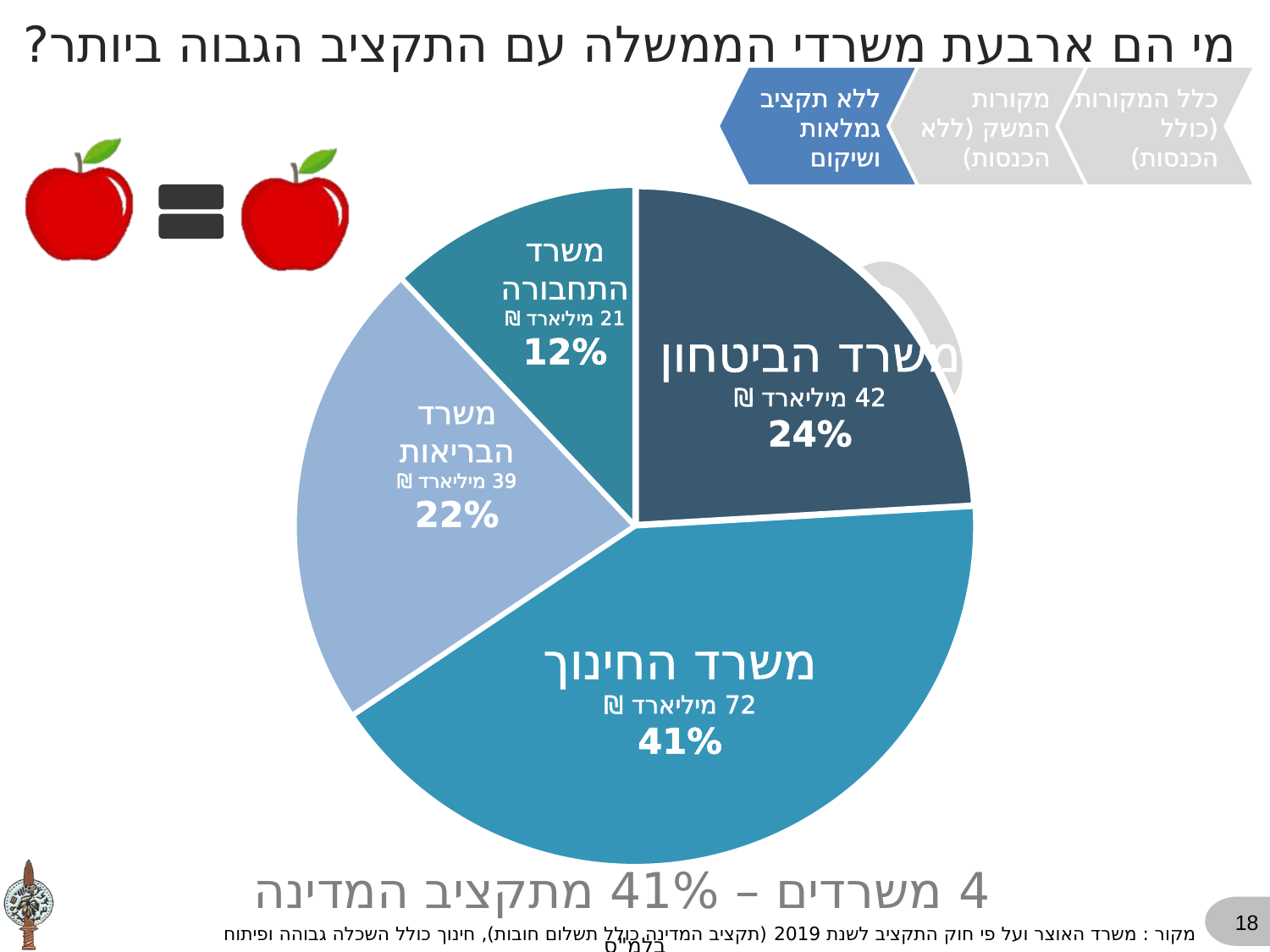
What percentage of the pie is the slice for משרד החינוך (Ministry of Education)? 41% What percentage of the pie is the slice for משרד התחבורה (Ministry of Transportation)? 12% Which ministry has the smallest slice of the pie? משרד התחבורה What budget value is printed for משרד החינוך (Ministry of Education)? 72 מיליארד ₪ What is the difference in billions of ₪ between the budgets of משרד הביטחון (42) and משרד הבריאות (39)? 3 What percentage of the pie is the slice for משרד הבריאות (Ministry of Health)? 22% How many slices does the pie chart have? 4 Which has a larger budget, משרד הבריאות (Ministry of Health) or משרד התחבורה (Ministry of Transportation)? משרד הבריאות What kind of chart is shown on the slide? pie chart Which ministry has the largest slice of the pie? משרד החינוך What budget value is printed for משרד הביטחון (Ministry of Defense)? 42 מיליארד ₪